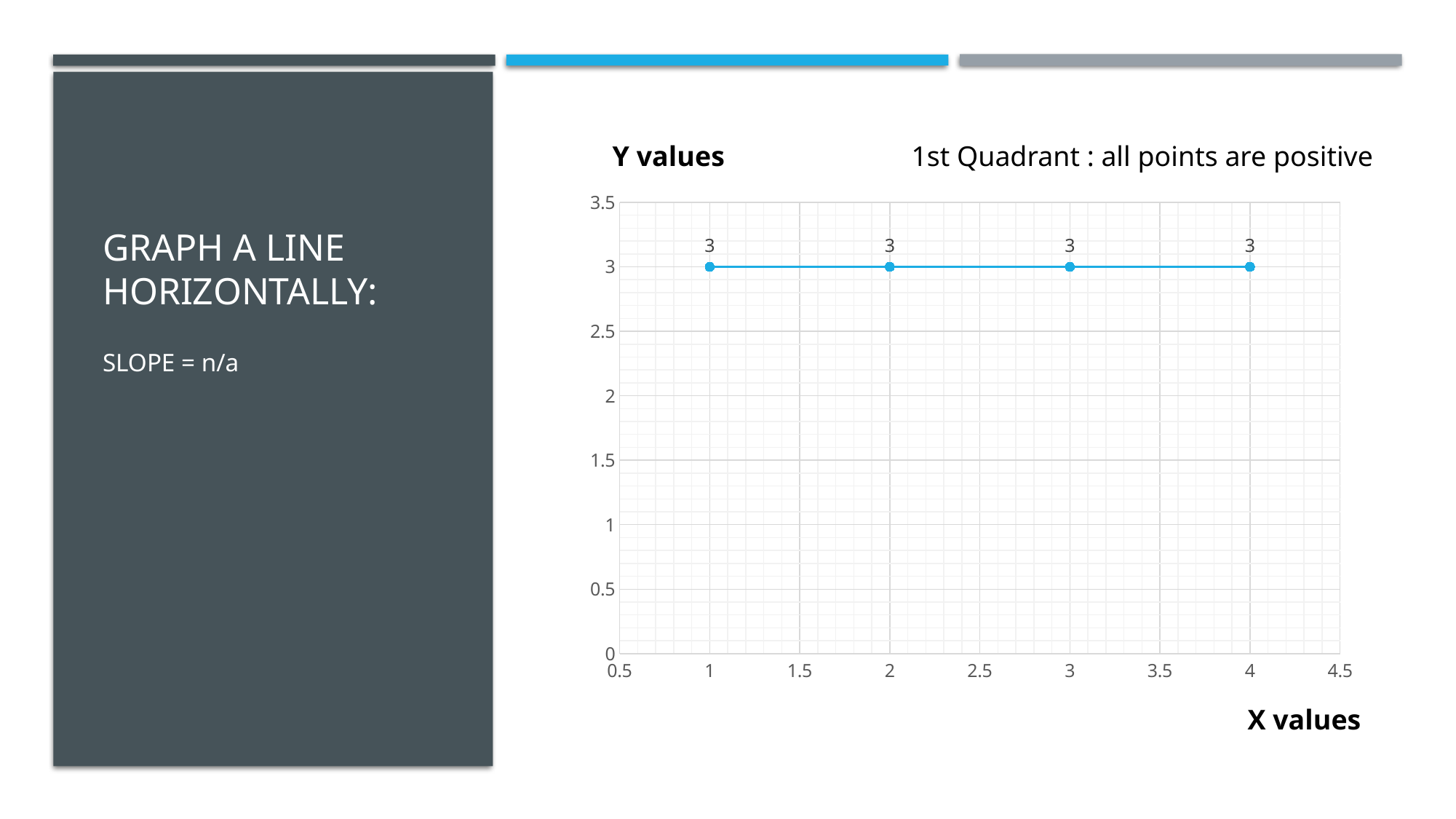
What kind of chart is shown on the slide? line chart How many data points are plotted on the chart? 4 What is the label of the vertical axis? Y values What is the difference between the Y value at X = 3 and the Y value at X = 1? 0 Is the Y value at X = 3 greater or less than 3.5? less Do the Y values rise, fall, or stay the same as X increases from 1 to 4? stay the same What is the label of the horizontal axis? X values What is the Y value at X = 4? 3 What is the Y value at X = 2? 3 What is the Y value at X = 1? 3 Is the Y value at X = 2 greater or less than 2.5? greater